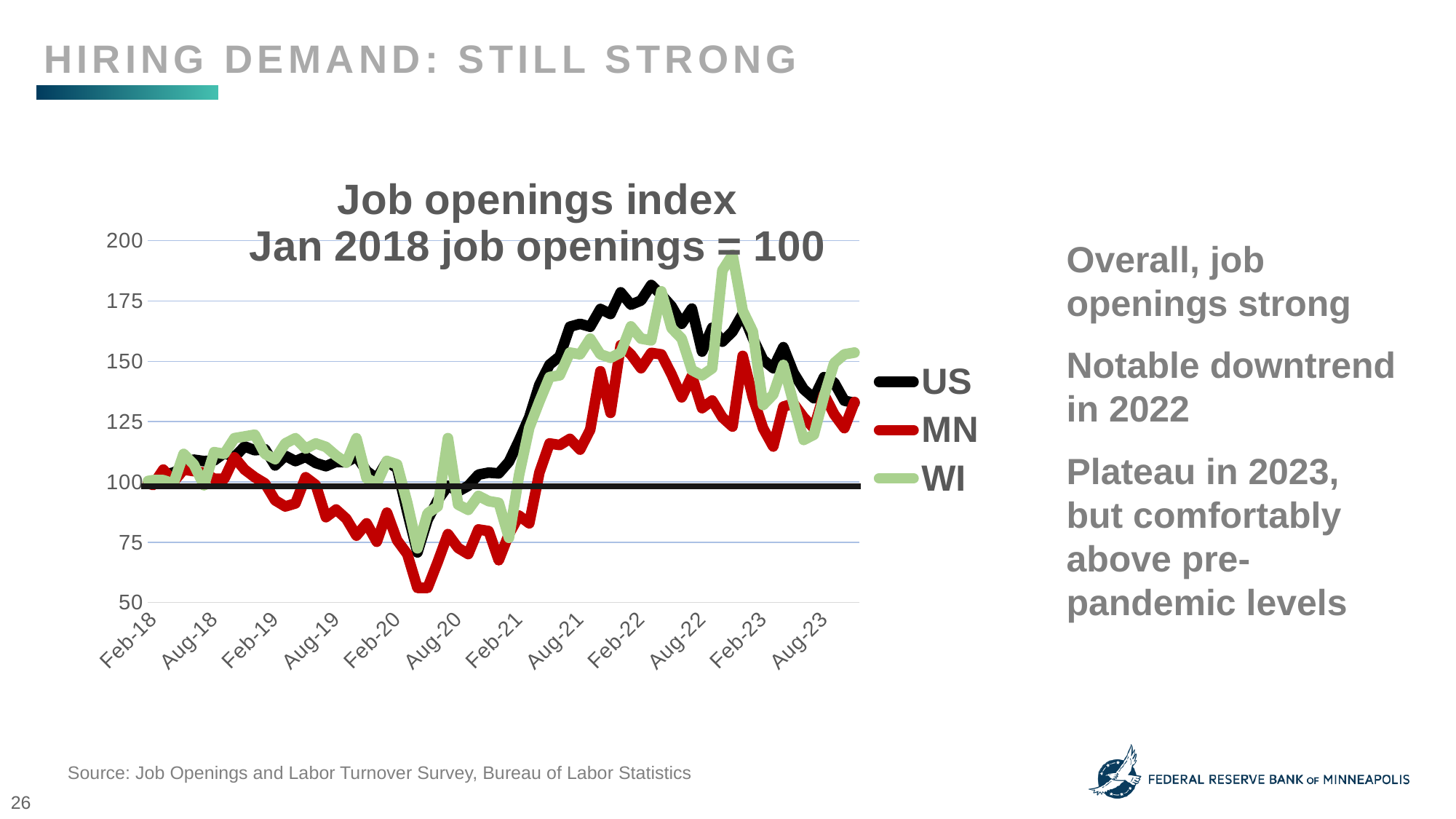
Is the lowest value of the MN series greater or less than 75? less Which colour is used for the MN series? red Is the peak value of the WI series greater or less than 175? greater Does the US series rise or fall between Feb-22 and Feb-23? fall Which series reaches the highest peak on the chart? WI What kind of chart is shown on the slide? line chart How many series does the chart legend list? 3 Does the US series rise or fall between Feb-21 and Feb-22? rise How many date labels are shown on the x axis? 12 Which series falls to the lowest point on the chart? MN Is the peak value of the US series greater or less than 175? greater What is the title of the chart? Job openings index Jan 2018 job openings = 100